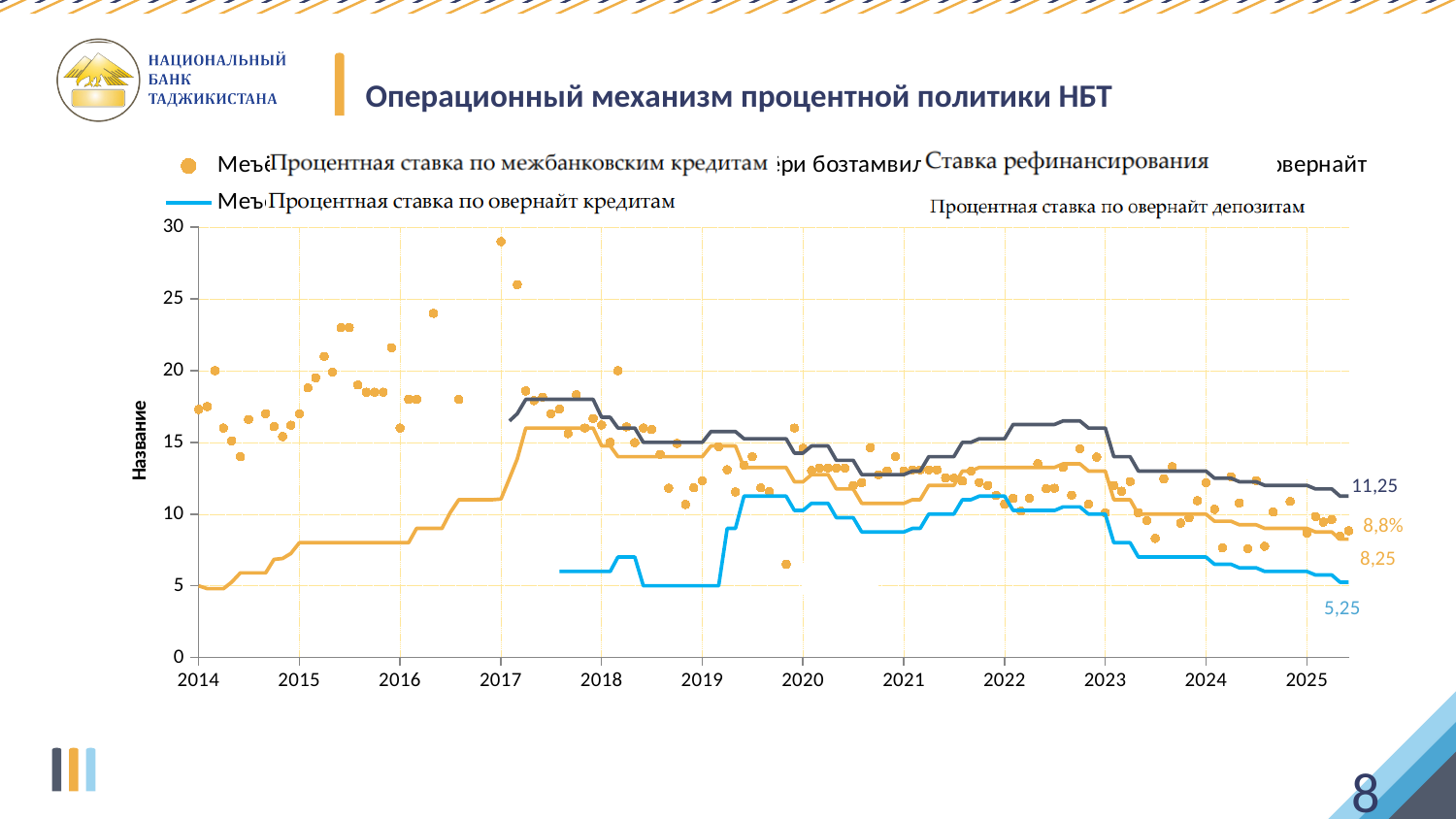
Is the value of the blue line at the start of 2019 greater or less than 10? less What is the value labelled at the right end of the dark grey line? 11,25 What kind of chart is shown on the slide? line chart What is the value labelled at the right end of the orange line? 8,25 What is the value labelled at the right end of the blue line? 5,25 What value is labelled in orange with a percent sign at the right edge of the chart? 8,8% Does the dark grey line rise or fall between 2023 and 2025? fall What is the title of the vertical axis? Название What is the difference between the labelled end values of the dark grey line (11,25) and the blue line (5,25)? 6 Is the value of the dark grey line in mid-2022 greater or less than 15? greater Which of the labelled end values on the right of the chart is the lowest? 5,25 Which of the labelled end values on the right of the chart is the highest? 11,25